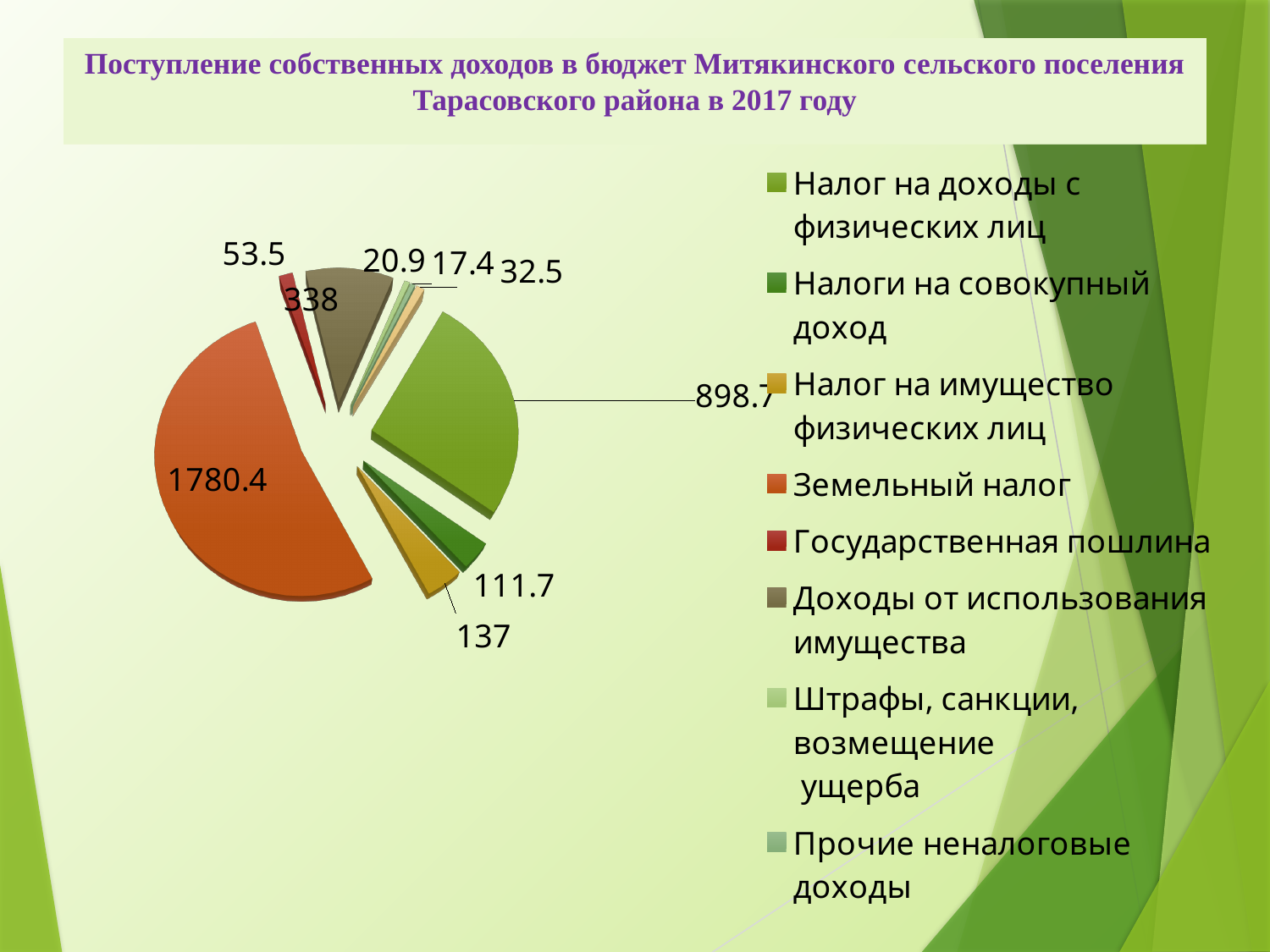
Which category has the largest slice of the pie? Земельный налог Which year does the chart title refer to? 2017 What is the value for Доходы от использования имущества? 338 What is the value for Земельный налог? 1780.4 What is the value for Налог на имущество физических лиц? 137 What kind of chart is shown on the slide? pie chart What is the value for Государственная пошлина? 53.5 What is the value for Налог на доходы с физических лиц? 898.7 What is the difference between the values for Земельный налог and Налог на доходы с физических лиц? 881.7 Which is larger: Налог на имущество физических лиц or Налоги на совокупный доход? Налог на имущество физических лиц What is the difference between the values for Доходы от использования имущества and Государственная пошлина? 284.5 What is the value for Налоги на совокупный доход? 111.7